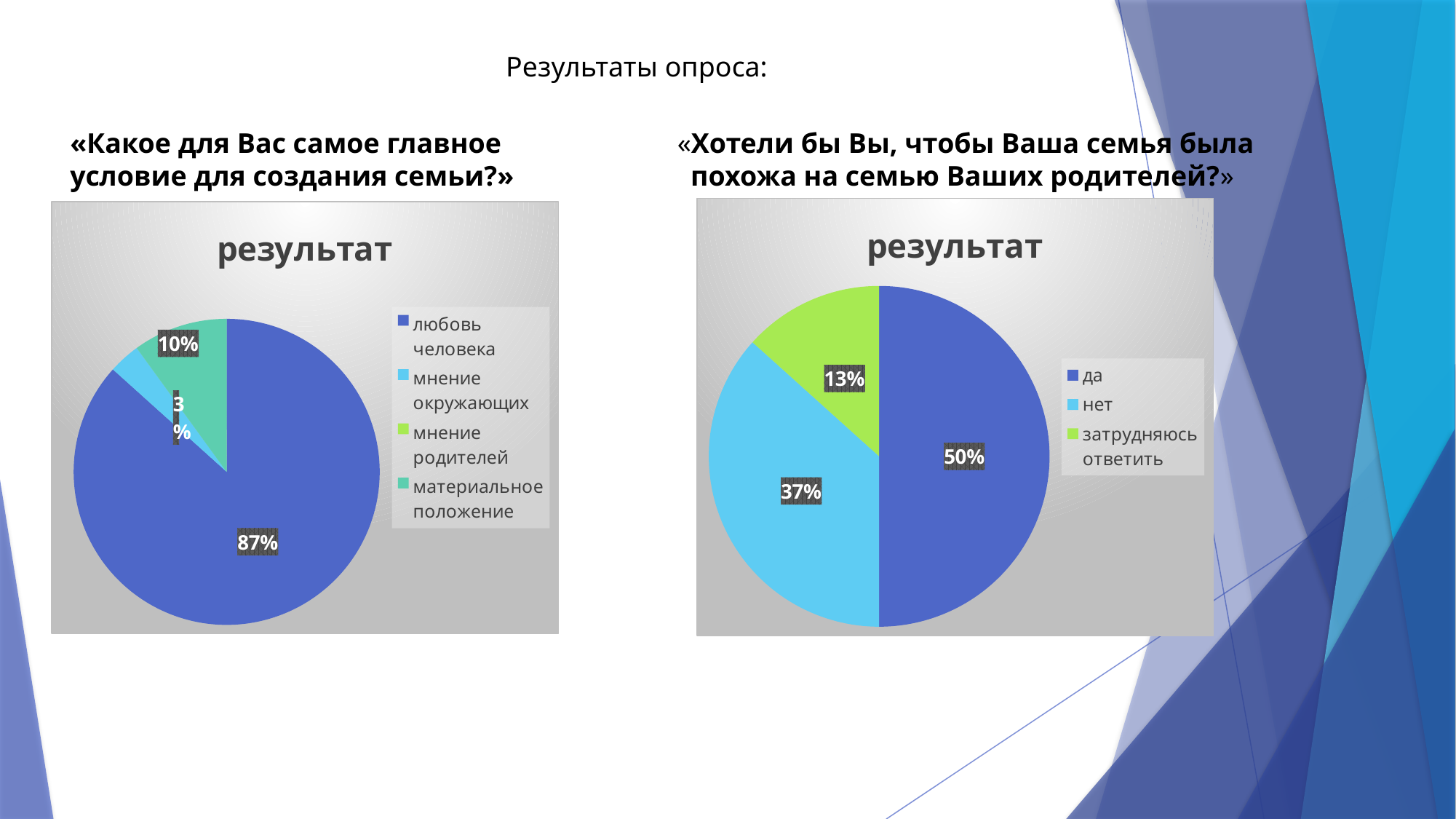
What type of chart is used for both charts on the slide? Pie chart In the left pie chart ("Какое для Вас самое главное условие для создания семьи?"), what share is labelled for "любовь человека"? 87% In the right pie chart ("Хотели бы Вы, чтобы Ваша семья была похожа на семью Ваших родителей?"), what share is labelled for "нет"? 37% In the left pie chart ("Какое для Вас самое главное условие для создания семьи?"), how many percentage points larger is "любовь человека" than "материальное положение"? 77% In the right pie chart ("Хотели бы Вы, чтобы Ваша семья была похожа на семью Ваших родителей?"), what share is labelled for "затрудняюсь ответить"? 13% In the right pie chart ("Хотели бы Вы, чтобы Ваша семья была похожа на семью Ваших родителей?"), which category has the smallest slice? затрудняюсь ответить In the left pie chart ("Какое для Вас самое главное условие для создания семьи?"), how many entries does the legend list? 4 In the left pie chart ("Какое для Вас самое главное условие для создания семьи?"), what share is labelled for "материальное положение"? 10% In the right pie chart ("Хотели бы Вы, чтобы Ваша семья была похожа на семью Ваших родителей?"), what share is labelled for "да"? 50% In the right pie chart ("Хотели бы Вы, чтобы Ваша семья была похожа на семью Ваших родителей?"), how many percentage points larger is "да" than "нет"? 13% In the left pie chart ("Какое для Вас самое главное условие для создания семьи?"), what share is labelled for "мнение окружающих"? 3% In the left pie chart ("Какое для Вас самое главное условие для создания семьи?"), which category has the largest slice? любовь человека